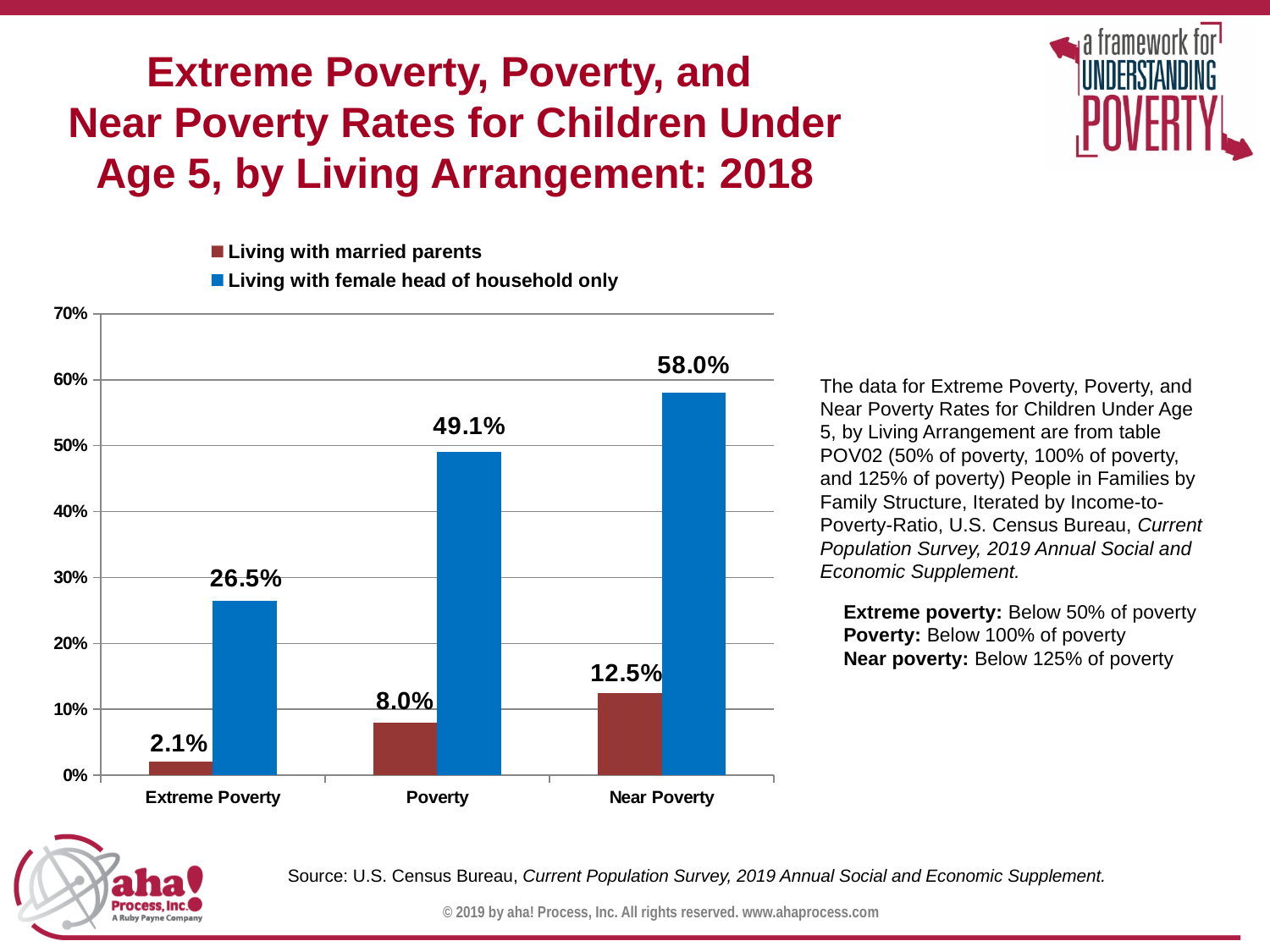
What is the Near Poverty rate for children living with a female head of household only? 58.0% What is the Poverty rate for children living with a female head of household only? 49.1% What is the Near Poverty rate for children living with married parents? 12.5% What is the Extreme Poverty rate for children living with married parents? 2.1% Which is larger: the Extreme Poverty rate for children living with a female head of household only or the Near Poverty rate for children living with married parents? Extreme Poverty rate for children living with a female head of household only Which category has the lowest rate for children living with married parents? Extreme Poverty Which category has the highest rate for children living with a female head of household only? Near Poverty What kind of chart is shown on the slide? Bar chart Do the rates for children living with married parents rise or fall from Extreme Poverty to Near Poverty? Rise How many living-arrangement series does the legend list? 2 How many poverty categories are shown on the x axis? 3 What is the difference between the Poverty rates for children living with a female head of household only and children living with married parents? 41.1%